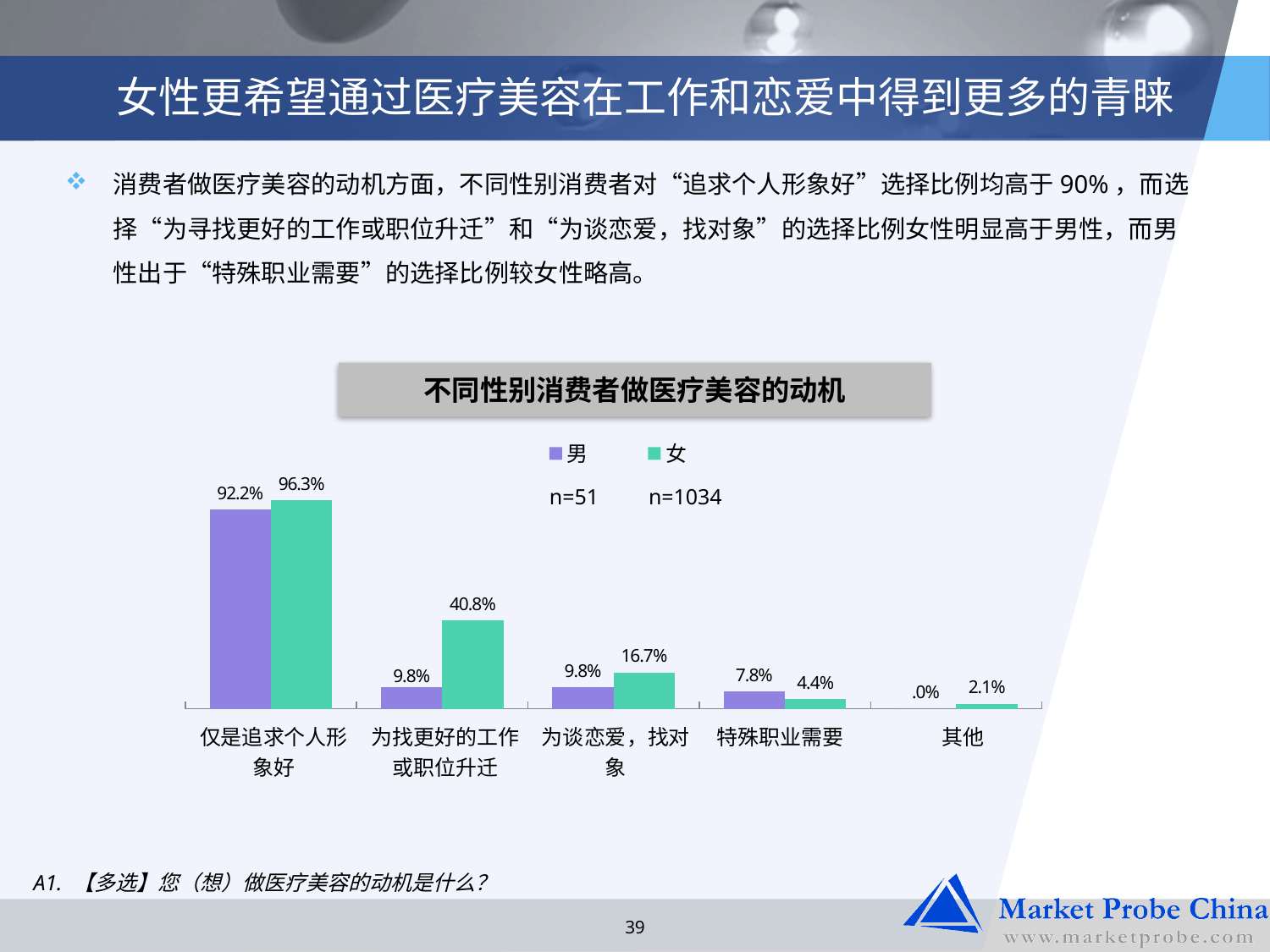
Which category has the lowest value for 男? 其他 How many categories are shown on the x axis? 5 Which category has the highest value for 女? 仅是追求个人形象好 What is the title of the chart? 不同性别消费者做医疗美容的动机 What is the value for 男 in the 特殊职业需要 category? 7.8% What is the value for 男 in the 为找更好的工作或职位升迁 category? 9.8% How many series does the legend list? 2 What is the value for 女 in the 为谈恋爱，找对象 category? 16.7% What is the difference between the 女 and 男 values in the 为找更好的工作或职位升迁 category? 31.0% What is the value for 女 in the 仅是追求个人形象好 category? 96.3% In the 特殊职业需要 category, which series has the larger value, 男 or 女? 男 What kind of chart is shown on the slide? Bar chart